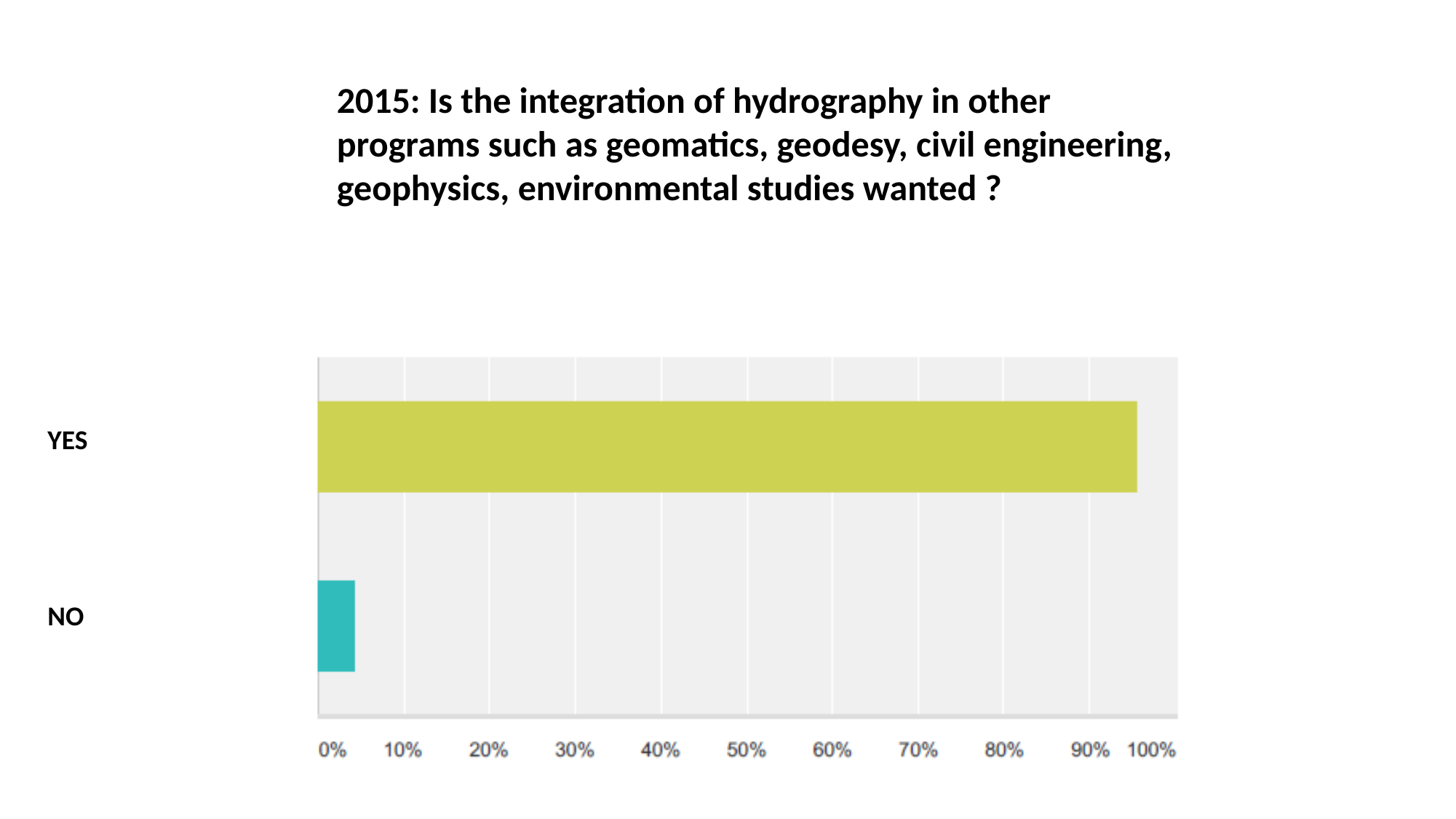
Which category has the highest value? YES How many categories does the chart show? 2 Which category has the lowest value? NO What kind of chart is shown on the slide? bar chart Which is larger, the value for YES or the value for NO? YES What is the highest tick label shown on the x axis? 100% Is the value for YES greater or less than 90%? greater What colour is the bar for NO? teal Is the value for YES greater or less than 50%? greater Is the value for NO greater or less than 10%? less